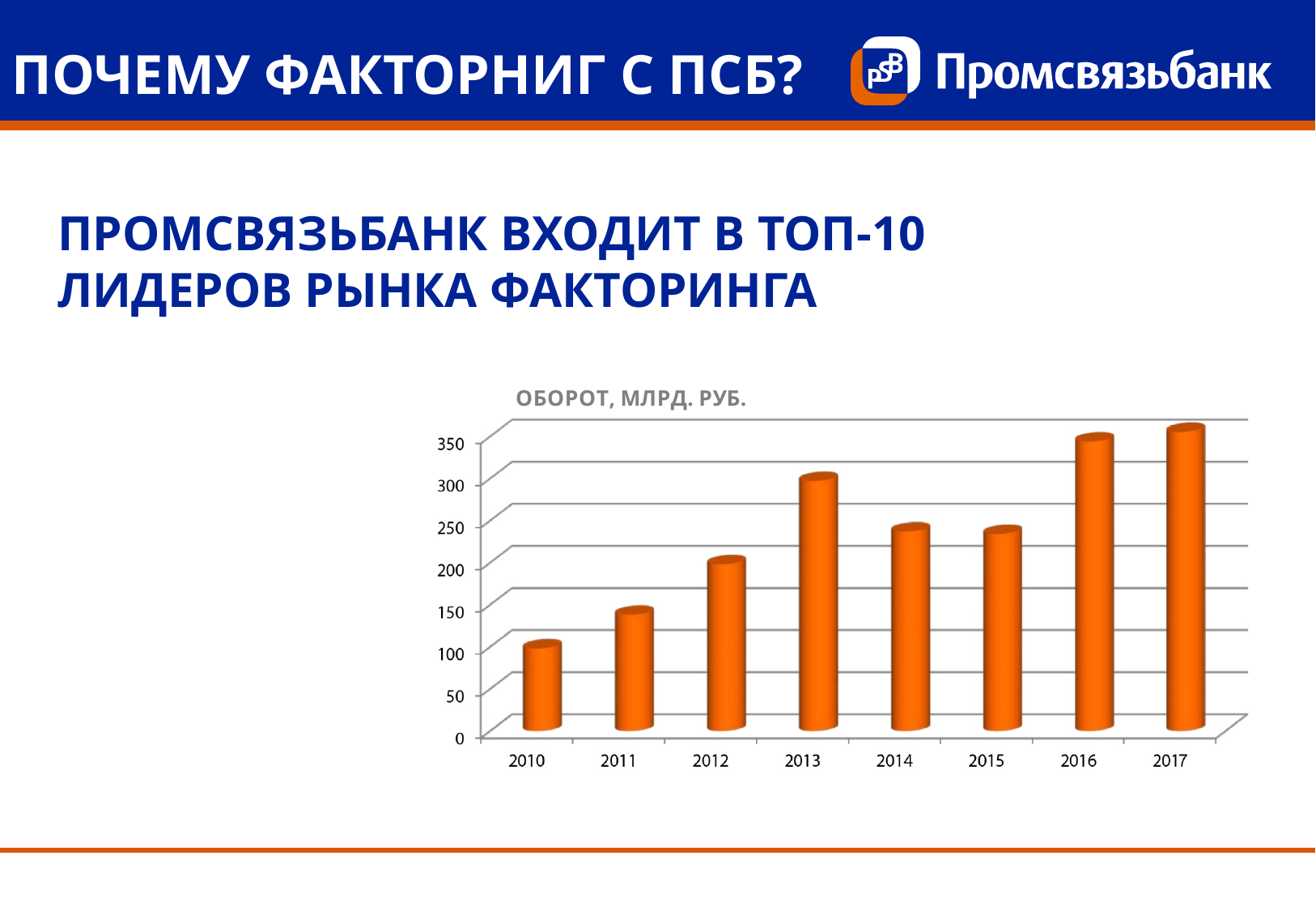
How many years are shown on the x axis of the chart? 8 What is the title of the chart? ОБОРОТ, МЛРД. РУБ. Is the value for 2012 greater or less than 250? less Is the value for 2014 greater or less than 300? less Is the value for 2010 greater or less than 150? less Which year has the lowest value in the chart? 2010 What kind of chart is shown on the slide? bar chart Which is larger, the value for 2013 or the value for 2014? 2013 What colour are the bars in the chart? orange Do the values rise or fall from 2010 to 2013? rise